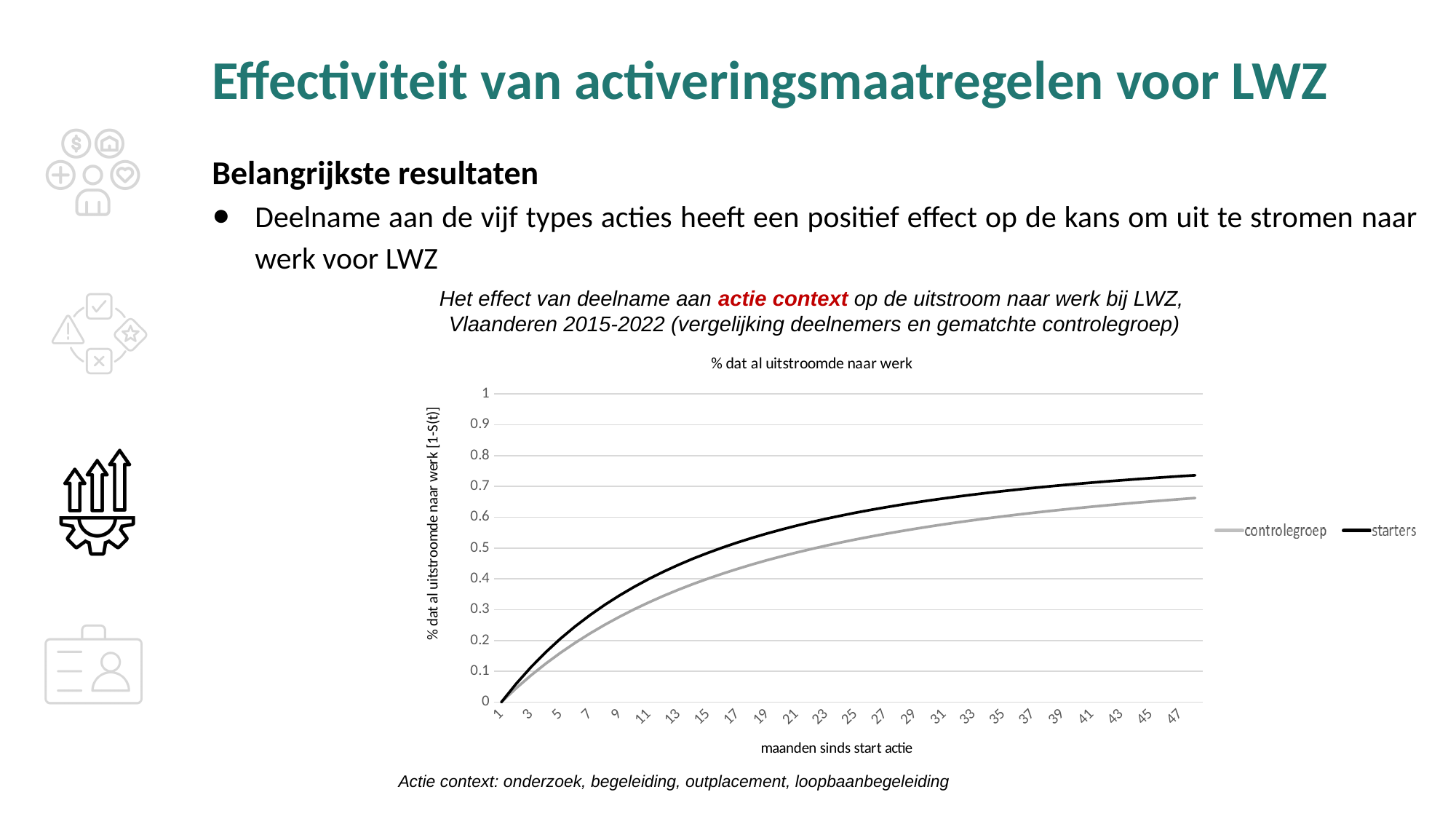
What kind of chart is shown on the slide? line chart Is the value for controlegroep at month 47 greater or less than 0.7? less Which series reaches the highest value on the chart? starters Is the value for starters at month 47 greater or less than 0.7? greater What is the title printed above the chart's plot area? % dat al uitstroomde naar werk How many series does the chart legend list? 2 Do the values of the starters series rise or fall as the months since the start of the action increase? rise What is the highest value shown on the chart's y axis? 1 Which two series are listed in the chart legend? controlegroep and starters Is the value for starters at month 9 greater or less than 0.3? greater Which series is higher at month 47, controlegroep or starters? starters